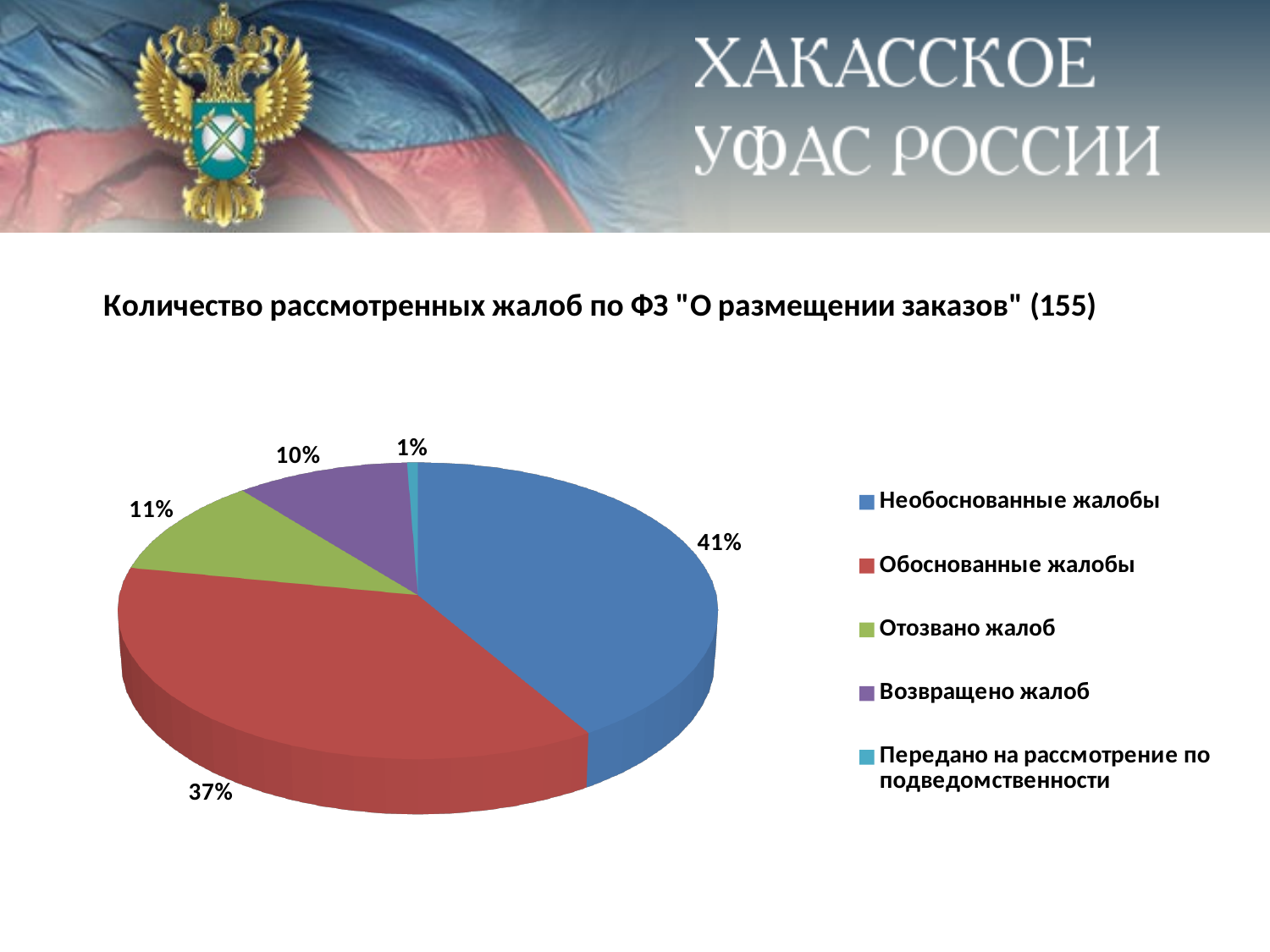
How many categories does the legend list? 5 What is the title of the chart? Количество рассмотренных жалоб по ФЗ "О размещении заказов" (155) What is the difference in percentage points between Необоснованные жалобы and Обоснованные жалобы? 4 What kind of chart is shown on the slide? Pie chart What share of the pie is labelled for Передано на рассмотрение по подведомственности? 1% What share of the pie is labelled for Возвращено жалоб? 10% Which is larger: the share for Отозвано жалоб or the share for Возвращено жалоб? Отозвано жалоб What share of the pie is labelled for Обоснованные жалобы? 37% Which category has the smallest share of the pie? Передано на рассмотрение по подведомственности Which category has the largest share of the pie? Необоснованные жалобы